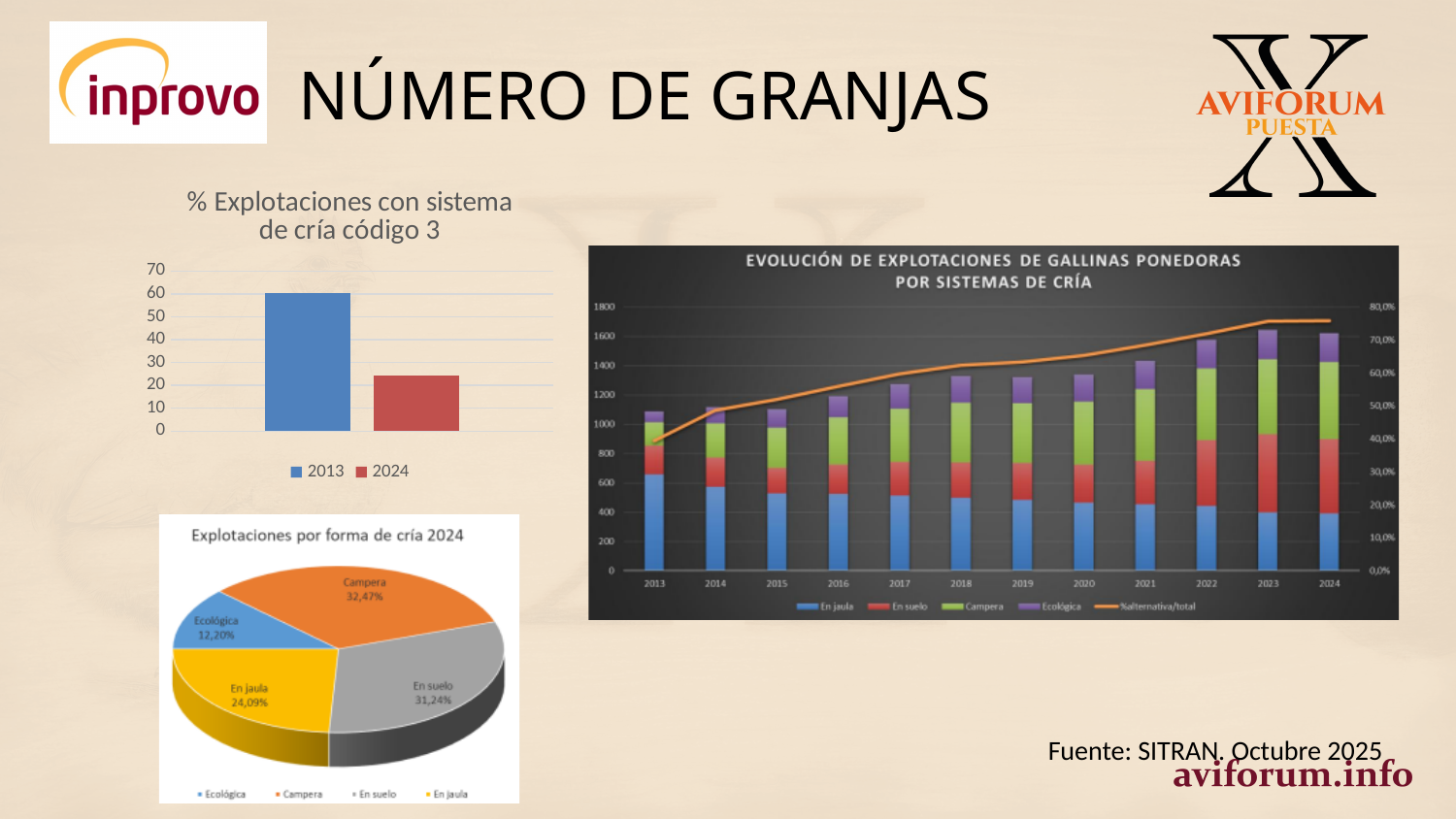
In the pie chart 'Explotaciones por forma de cría 2024', which is larger, En suelo or En jaula? En suelo In the chart '% Explotaciones con sistema de cría código 3', is the value for 2013 greater or less than 50? greater In the chart 'Evolución de explotaciones de gallinas ponedoras por sistemas de cría', how many years are shown on the x axis? 12 In the chart 'Evolución de explotaciones de gallinas ponedoras por sistemas de cría', how many series does the legend list? 5 In the pie chart 'Explotaciones por forma de cría 2024', what is the difference between the Campera and En suelo percentages? 1,23% In the pie chart 'Explotaciones por forma de cría 2024', what percentage is shown for Ecológica? 12,20% In the pie chart 'Explotaciones por forma de cría 2024', which category has the smallest slice? Ecológica In the chart '% Explotaciones con sistema de cría código 3', is the value for 2024 greater or less than 30? less In the pie chart 'Explotaciones por forma de cría 2024', how many slices are there? 4 In the pie chart 'Explotaciones por forma de cría 2024', which category has the largest slice? Campera In the chart '% Explotaciones con sistema de cría código 3', which year has the larger value, 2013 or 2024? 2013 In the pie chart 'Explotaciones por forma de cría 2024', what percentage is shown for Campera? 32,47%